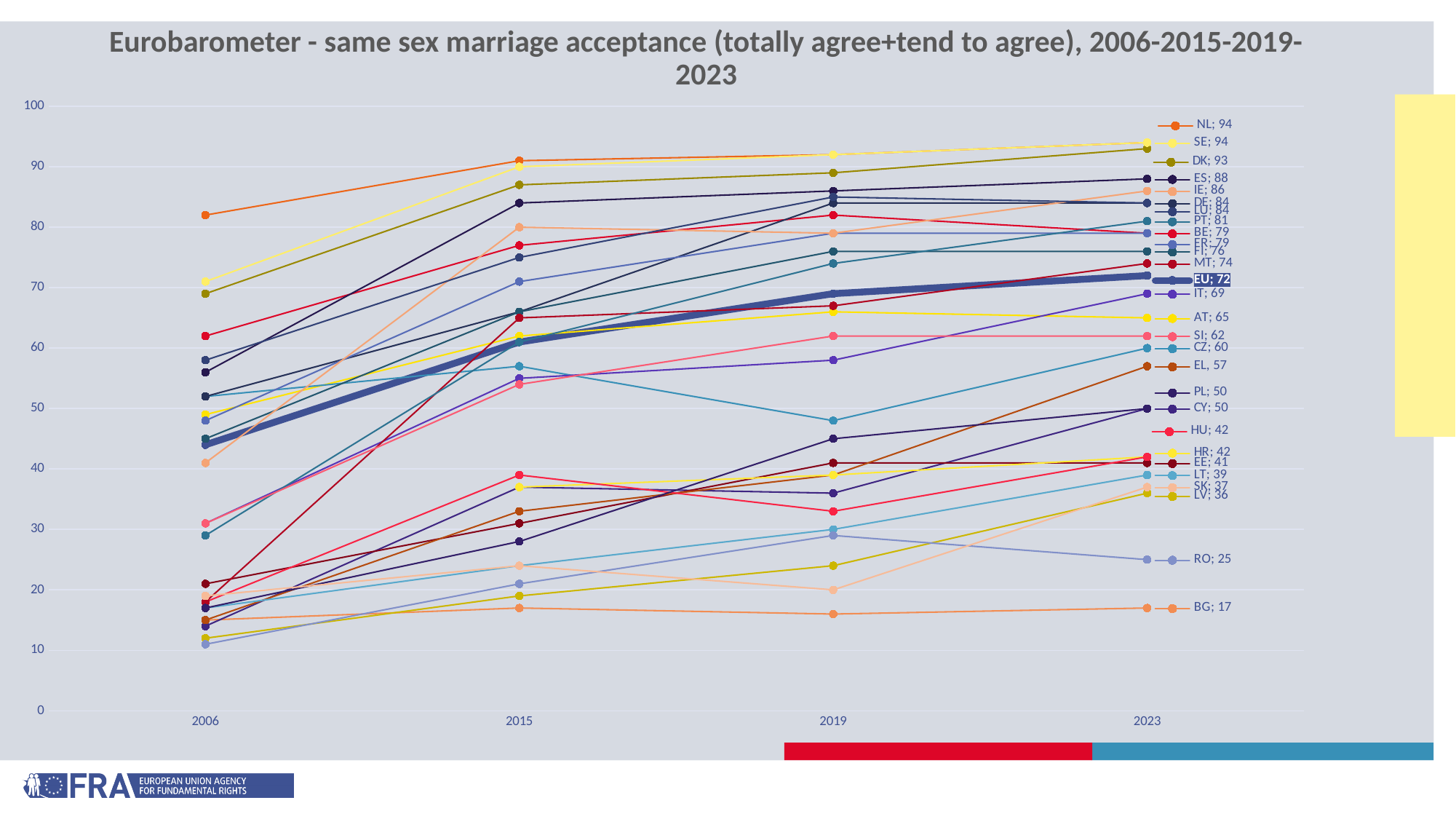
What kind of chart is shown on the slide? line chart Is the EU value for 2006 greater or less than 50? less How many years are shown on the x axis? 4 What is the difference between the 2023 values for NL and BG? 77 What is the difference between the 2023 values for EU and IT? 3 Which has the higher 2023 value, ES or IE? ES Which country has the lowest value in 2023? BG What is the EU value for 2023? 72 What is the value for BG in 2023? 17 What is the value for RO in 2023? 25 Does the EU line rise or fall from 2006 to 2023? rises What is the value for DK in 2023? 93